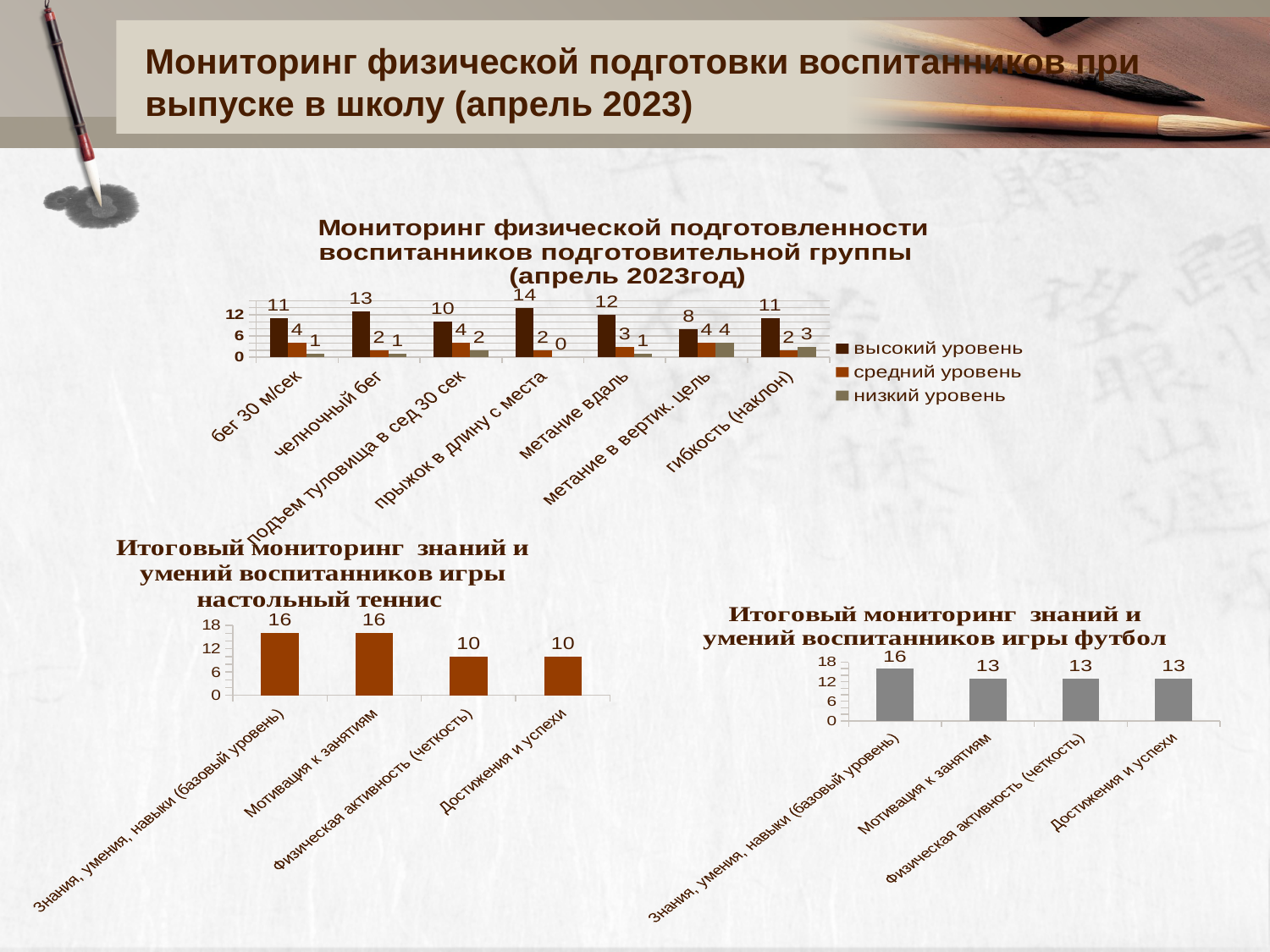
In the bottom-right chart (футбол), what is the value for Знания, умения, навыки (базовый уровень)? 16 In the top chart (Мониторинг физической подготовленности), what is the difference between the высокий уровень and средний уровень values for челночный бег? 11 How many series does the legend of the top chart (Мониторинг физической подготовленности) list? 3 In the bottom-left chart (настольный теннис), what is the difference between Мотивация к занятиям and Достижения и успехи? 6 What type of chart is the bottom-right chart (футбол)? bar chart In the bottom-left chart (настольный теннис), what is the value for Физическая активность (четкость)? 10 In the top chart (Мониторинг физической подготовленности), which category has the lowest высокий уровень value? метание в вертик. цель In the top chart (Мониторинг физической подготовленности), what is the value of высокий уровень for прыжок в длину с места? 14 In the top chart (Мониторинг физической подготовленности), what is the value of низкий уровень for метание в вертик. цель? 4 How many categories are shown on the x axis of the top chart (Мониторинг физической подготовленности)? 7 In the bottom-right chart (футбол), which is larger: Знания, умения, навыки (базовый уровень) or Мотивация к занятиям? Знания, умения, навыки (базовый уровень) In the top chart (Мониторинг физической подготовленности), which category has the highest высокий уровень value? прыжок в длину с места